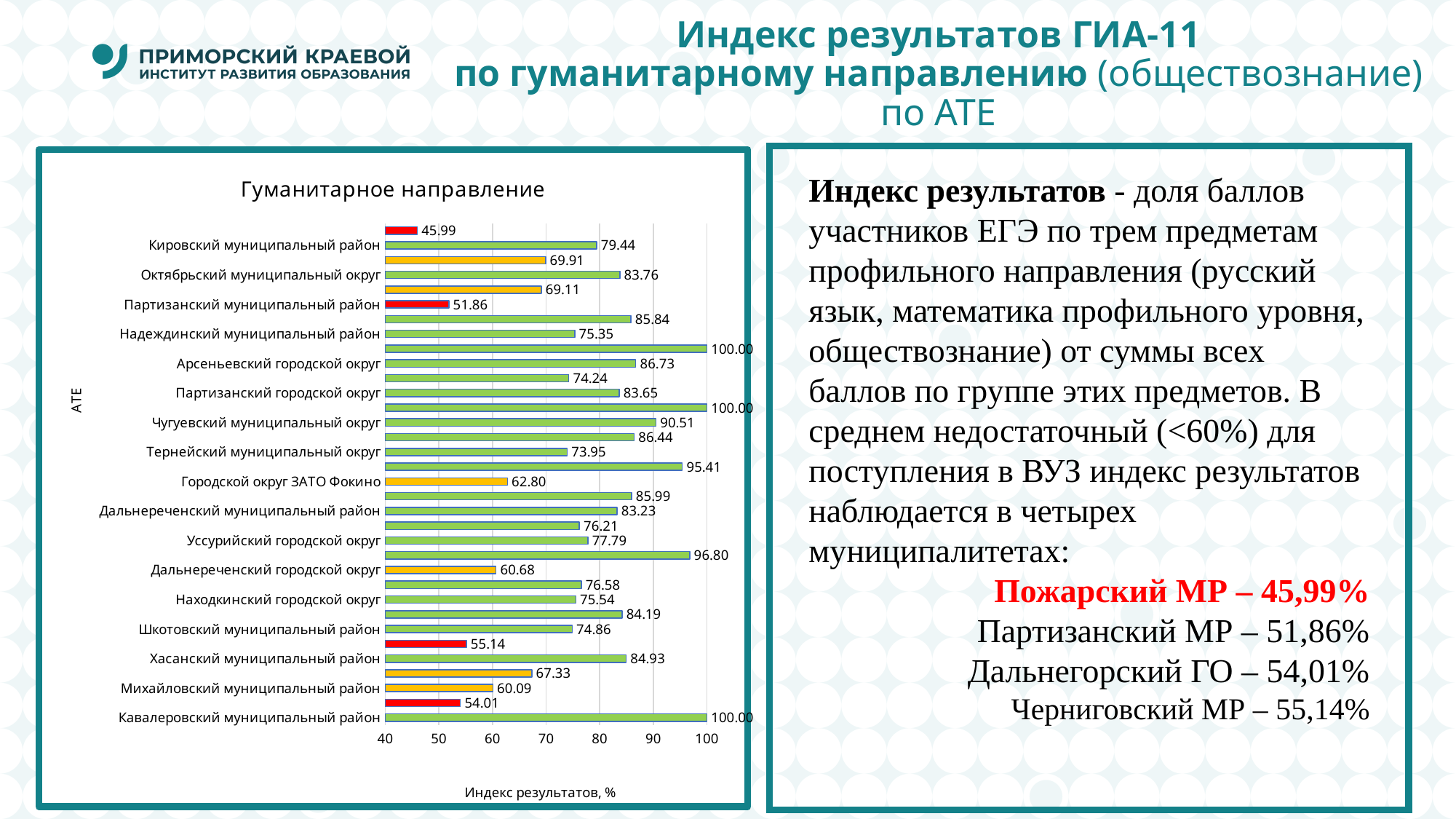
What is the value for Кавалеровский муниципальный район? 100.00 What kind of chart is shown on the slide? bar chart What is the value for Городской округ ЗАТО Фокино? 62.80 What is the lowest value shown on the chart? 45.99 What is the title of the chart? Гуманитарное направление How many bars on the chart reach the value 100.00? 3 What is the value for Кировский муниципальный район? 79.44 What is the difference between the values for Арсеньевский городской округ and Тернейский муниципальный округ? 12.78 Which has a larger value, Хасанский муниципальный район or Шкотовский муниципальный район? Хасанский муниципальный район What is the difference between the values for Октябрьский муниципальный округ and Кировский муниципальный район? 4.32 What is the value for Чугуевский муниципальный округ? 90.51 Is the value for Надеждинский муниципальный район greater or less than 70? greater